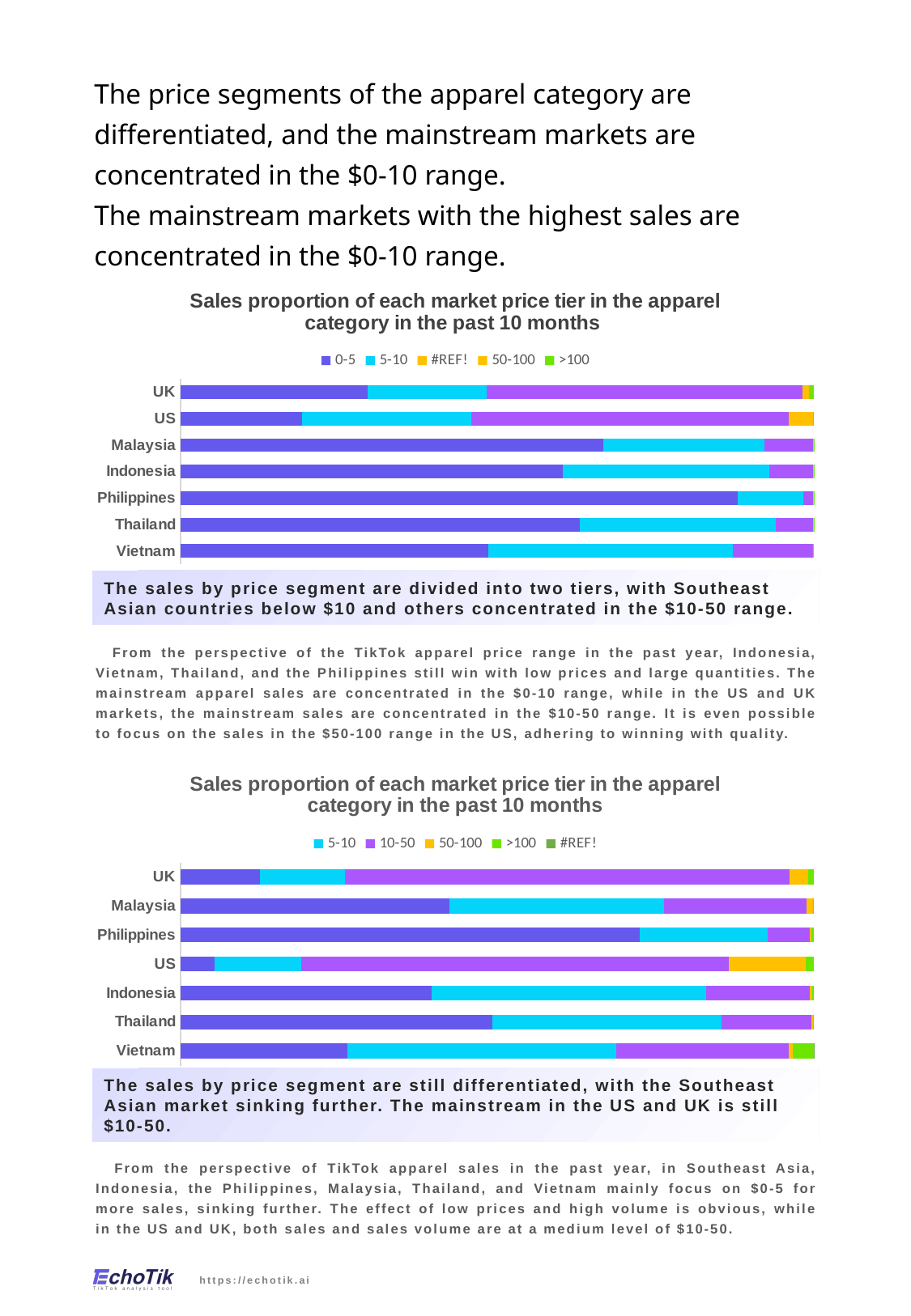
In the bottom chart, which market has the largest 50-100 segment? US In the bottom chart, is the leftmost segment of the bar larger for the UK or for Malaysia? Malaysia What is the title of the bottom chart? Sales proportion of each market price tier in the apparel category in the past 10 months How many series does the legend of the bottom chart list? 5 How many markets are shown in the bottom chart? 7 How many markets are shown in the top chart? 7 How many series does the legend of the top chart list? 5 In the top chart, is the 0-5 segment larger for the US or for the Philippines? Philippines What kind of chart is the top chart on the slide? bar chart In the top chart, which market has the largest 0-5 segment? Philippines In the top chart, which market has the smallest 0-5 segment? US In the top chart, which market has the smallest 5-10 segment? Philippines